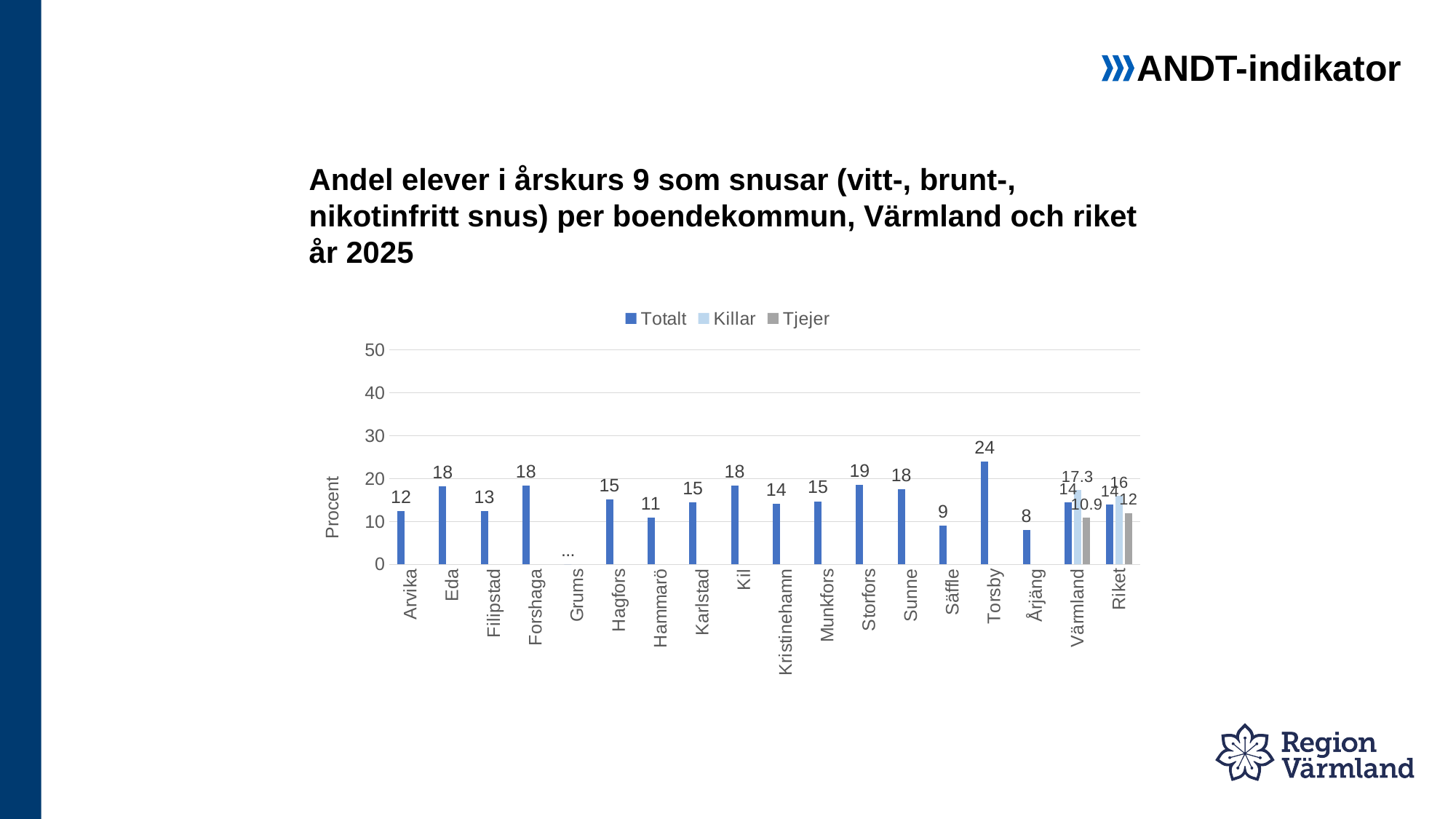
What kind of chart is shown on the slide? Bar chart What is the difference between the Totalt values for Torsby and Säffle? 15 What is the Tjejer value for Riket? 12 Which municipality has the highest Totalt value? Torsby Which has a higher Totalt value, Storfors or Hammarö? Storfors Is the Totalt value for Torsby greater or less than 20? greater Which municipality has the lowest Totalt value among those with a plotted bar? Årjäng What is the Totalt value for Torsby? 24 What is the label on the vertical axis? Procent What is the Killar value for Värmland? 17.3 What is the difference between the Killar and Tjejer values for Värmland? 6.4 How many series does the legend list? 3